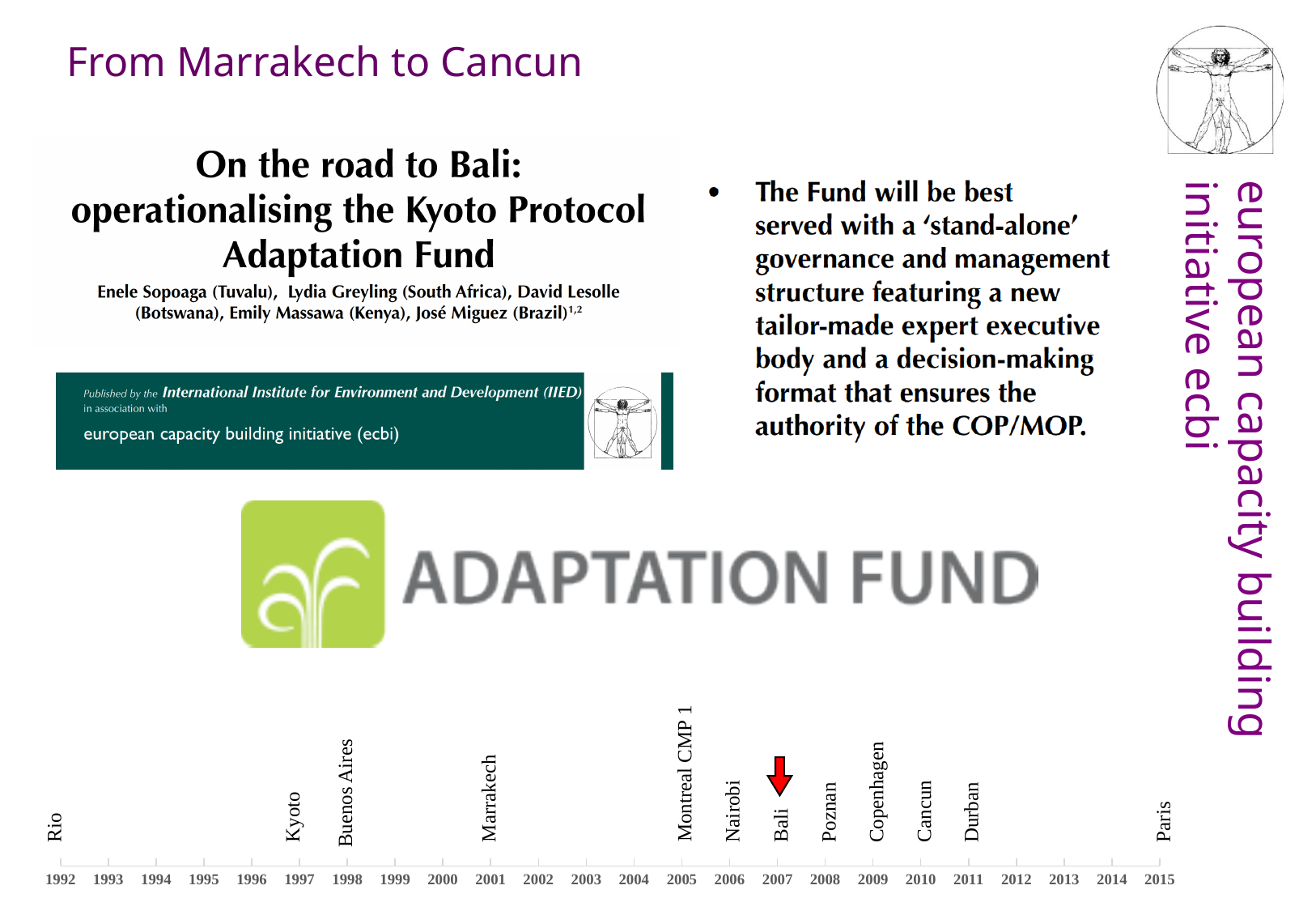
On the timeline at the bottom of the slide, how many labelled events are shown? 12 On the timeline at the bottom of the slide, which event does the red arrow point to? Bali On the timeline at the bottom of the slide, which year is Bali placed at? 2007 On the timeline at the bottom of the slide, which event is placed at 2010? Cancun On the timeline at the bottom of the slide, which event is placed at 2005? Montreal CMP 1 On the timeline at the bottom of the slide, which event is placed at 1997? Kyoto On the timeline at the bottom of the slide, what is the first year and the last year shown on the axis? 1992 and 2015 On the timeline at the bottom of the slide, how many years separate Marrakech (2001) and Cancun (2010)? 9 On the timeline at the bottom of the slide, which event is the earliest? Rio On the timeline at the bottom of the slide, which year is Marrakech placed at? 2001 On the timeline at the bottom of the slide, which comes later, Copenhagen or Poznan? Copenhagen On the timeline at the bottom of the slide, which event is the latest? Paris